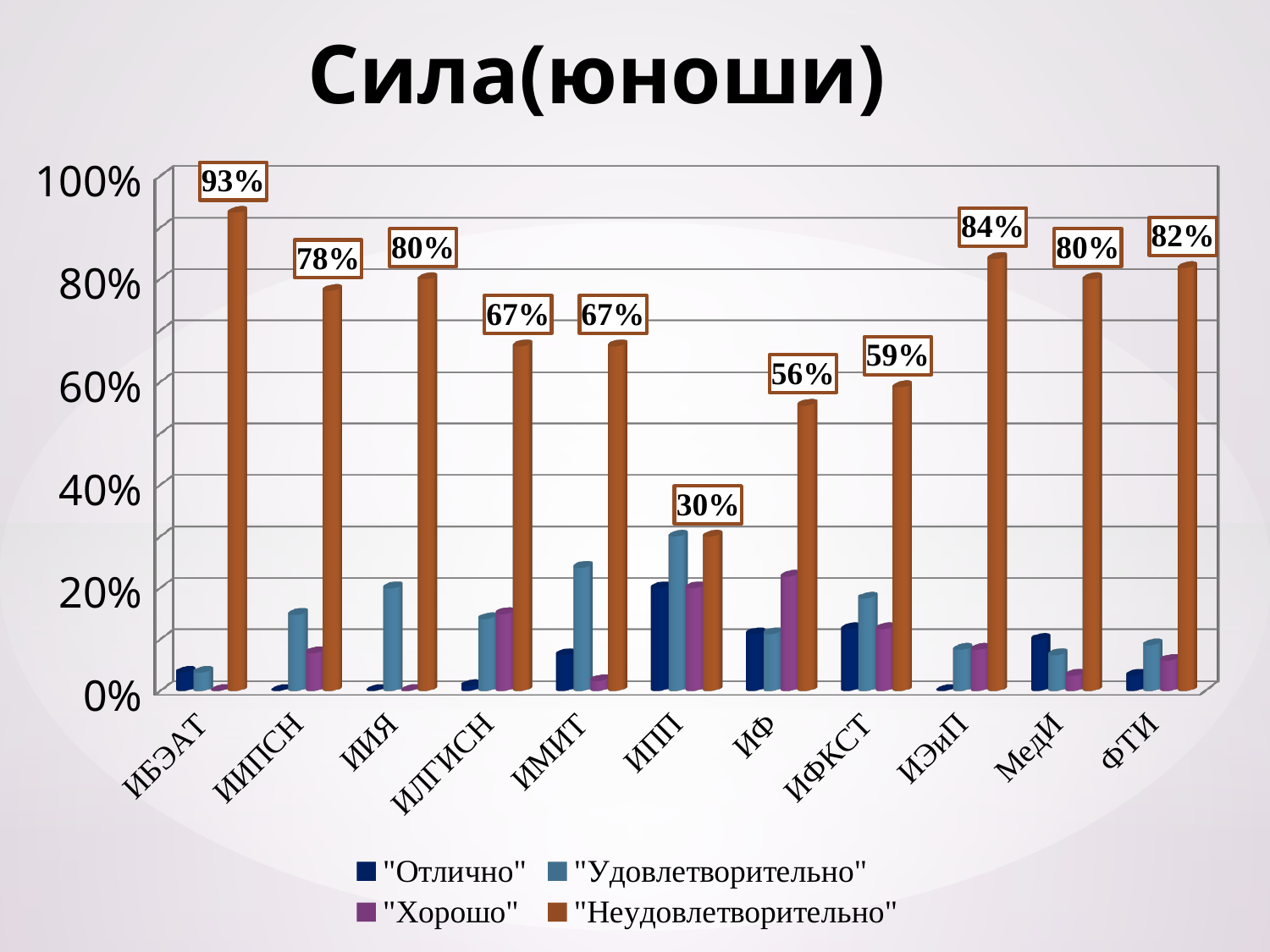
What is the value of the "Неудовлетворительно" series for ИЭиП? 84% What kind of chart is shown on the slide? bar chart Which has the larger "Неудовлетворительно" value, ИЭиП or ФТИ? ИЭиП How many categories are shown on the x axis? 11 Which category has the highest "Неудовлетворительно" value? ИБЭАТ What is the value of the "Неудовлетворительно" series for ИБЭАТ? 93% What is the value of the "Неудовлетворительно" series for ИФ? 56% Is the "Удовлетворительно" value for ИПП greater or less than 20%? greater Which category has the lowest "Неудовлетворительно" value? ИПП What is the difference between the "Неудовлетворительно" values for ИИЯ and ИИПСН? 2 percentage points How many series does the legend list? 4 What is the difference between the "Неудовлетворительно" values for ИБЭАТ and ИПП? 63 percentage points